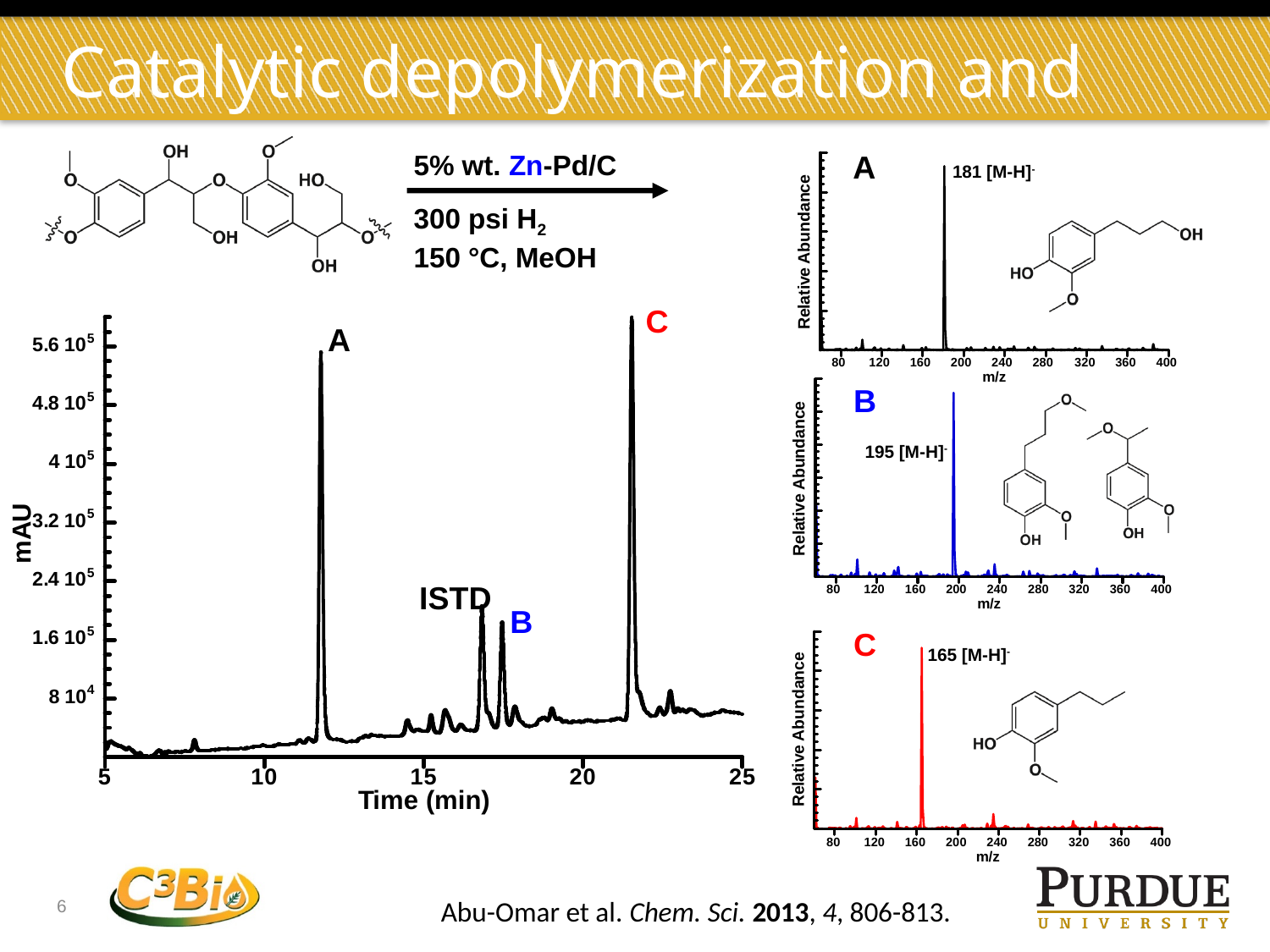
In the chromatogram, which labeled peak is taller, A or B? A In mass spectrum C, what m/z is labeled on the main peak? 165 [M-H]- In the chromatogram, is the height of the ISTD peak greater or less than 1.6 10^5 mAU? greater In the chromatogram, is the height of peak B greater or less than 2.4 10^5 mAU? less What is the x-axis label of the chromatogram? Time (min) In mass spectrum B, what m/z is labeled on the main peak? 195 [M-H]- How many labeled peaks are marked in the chromatogram? 4 In mass spectrum A, what m/z is labeled on the main peak? 181 [M-H]- In the chromatogram, which labeled peak elutes earlier, ISTD or B? ISTD In the chromatogram (mAU vs Time), which labeled peak is the tallest? C In the chromatogram, is the height of peak A greater or less than 4 10^5 mAU? greater What is the difference between the labeled m/z of the main peak in mass spectrum B and that in mass spectrum C? 30